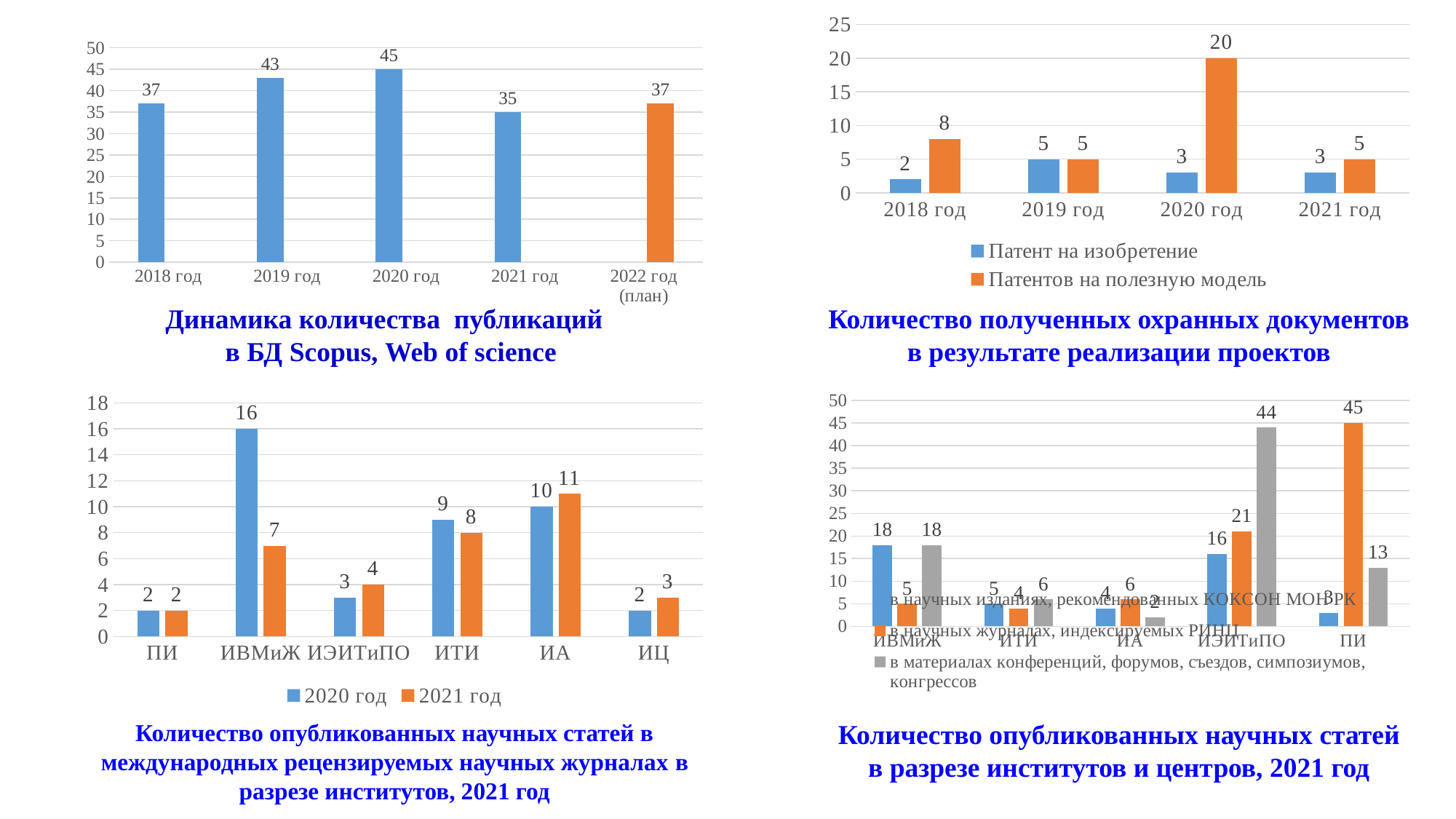
In the chart 'Динамика количества публикаций в БД Scopus, Web of science', what is the value for 2020 год? 45 In the chart 'Количество полученных охранных документов в результате реализации проектов', how many series does the legend list? 2 In the chart 'Количество опубликованных научных статей в разрезе институтов и центров, 2021 год', how many series does the legend list? 3 How many categories are shown on the x axis of the chart 'Динамика количества публикаций в БД Scopus, Web of science'? 5 In the chart 'Количество опубликованных научных статей в международных рецензируемых научных журналах в разрезе институтов, 2021 год', what is the value of '2020 год' for ИВМиЖ? 16 In the chart 'Количество полученных охранных документов в результате реализации проектов', what is the value of 'Патентов на полезную модель' for 2020 год? 20 In the chart 'Динамика количества публикаций в БД Scopus, Web of science', which year has the lowest value? 2021 год In the chart 'Динамика количества публикаций в БД Scopus, Web of science', what is the difference between the values for 2019 год and 2021 год? 8 In the chart 'Количество опубликованных научных статей в международных рецензируемых научных журналах в разрезе институтов, 2021 год', which institute has the highest value for '2021 год'? ИА What type of chart is 'Количество опубликованных научных статей в международных рецензируемых научных журналах в разрезе институтов, 2021 год'? bar chart In the chart 'Количество опубликованных научных статей в разрезе институтов и центров, 2021 год', what is the value of the gray series (в материалах конференций, форумов, съездов, симпозиумов, конгрессов) for ИЭИТиПО? 44 In the chart 'Количество полученных охранных документов в результате реализации проектов', which is larger for 2018 год: 'Патент на изобретение' or 'Патентов на полезную модель'? Патентов на полезную модель